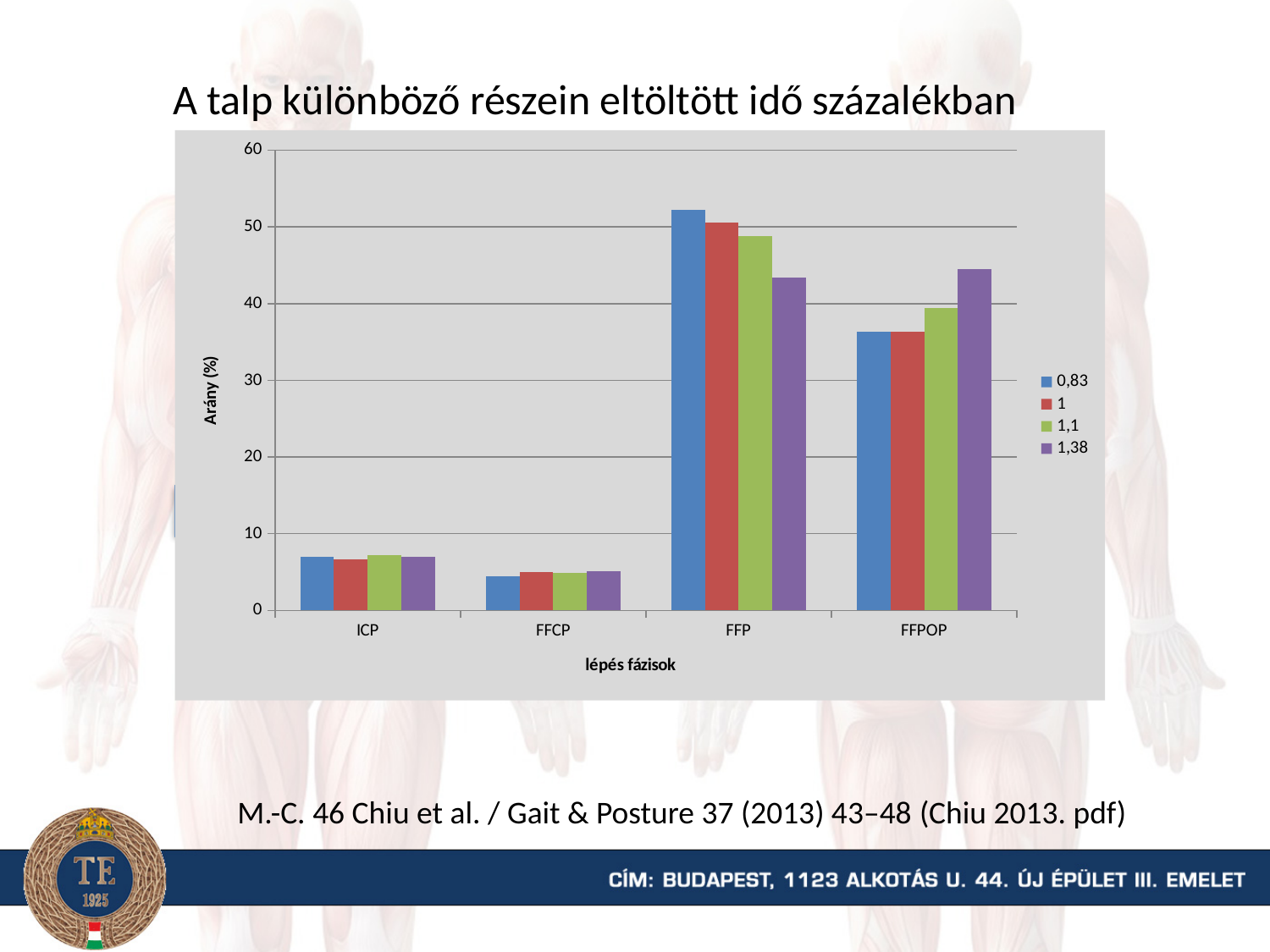
Is the value for ICP in the 1,1 series greater or less than 10? less For the FFP category, which series has the larger value, 0,83 or 1,38? 0,83 What kind of chart is shown on the slide? bar chart What is the title of the horizontal axis? lépés fázisok Which category has the lowest value for the 0,83 series? FFCP Is the value for FFP in the 1,38 series greater or less than 40? greater For the FFPOP category, which series has the larger value, 0,83 or 1,38? 1,38 Is the value for FFPOP in the 0,83 series greater or less than 40? less Which category has the highest value for the 0,83 series? FFP What is the title of the vertical axis? Arány (%) How many categories are shown on the x axis? 4 How many series does the legend list? 4